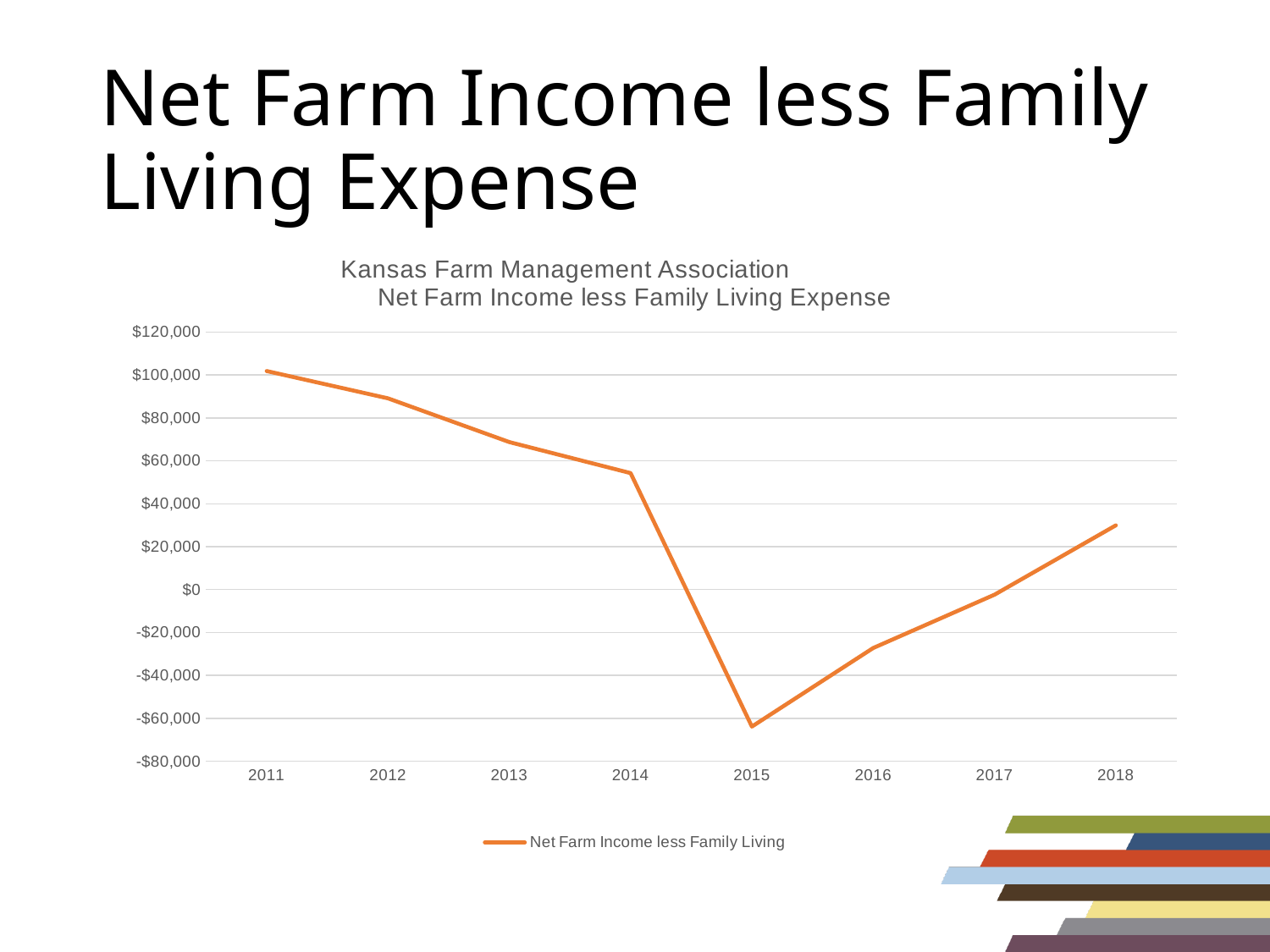
What is the name of the series shown in the chart's legend? Net Farm Income less Family Living In which year is Net Farm Income less Family Living lowest? 2015 In which year is Net Farm Income less Family Living highest? 2011 Is the value for 2015 greater or less than -$40,000? less Is the value for 2011 greater or less than $80,000? greater Do the values rise or fall from 2015 to 2018? rise Do the values rise or fall from 2011 to 2014? fall Is the value for 2018 greater or less than $20,000? greater How many series does the chart's legend list? 1 What kind of chart is shown on the slide? line chart Which year has the larger value, 2012 or 2013? 2012 How many years are plotted on the x axis of the chart? 8